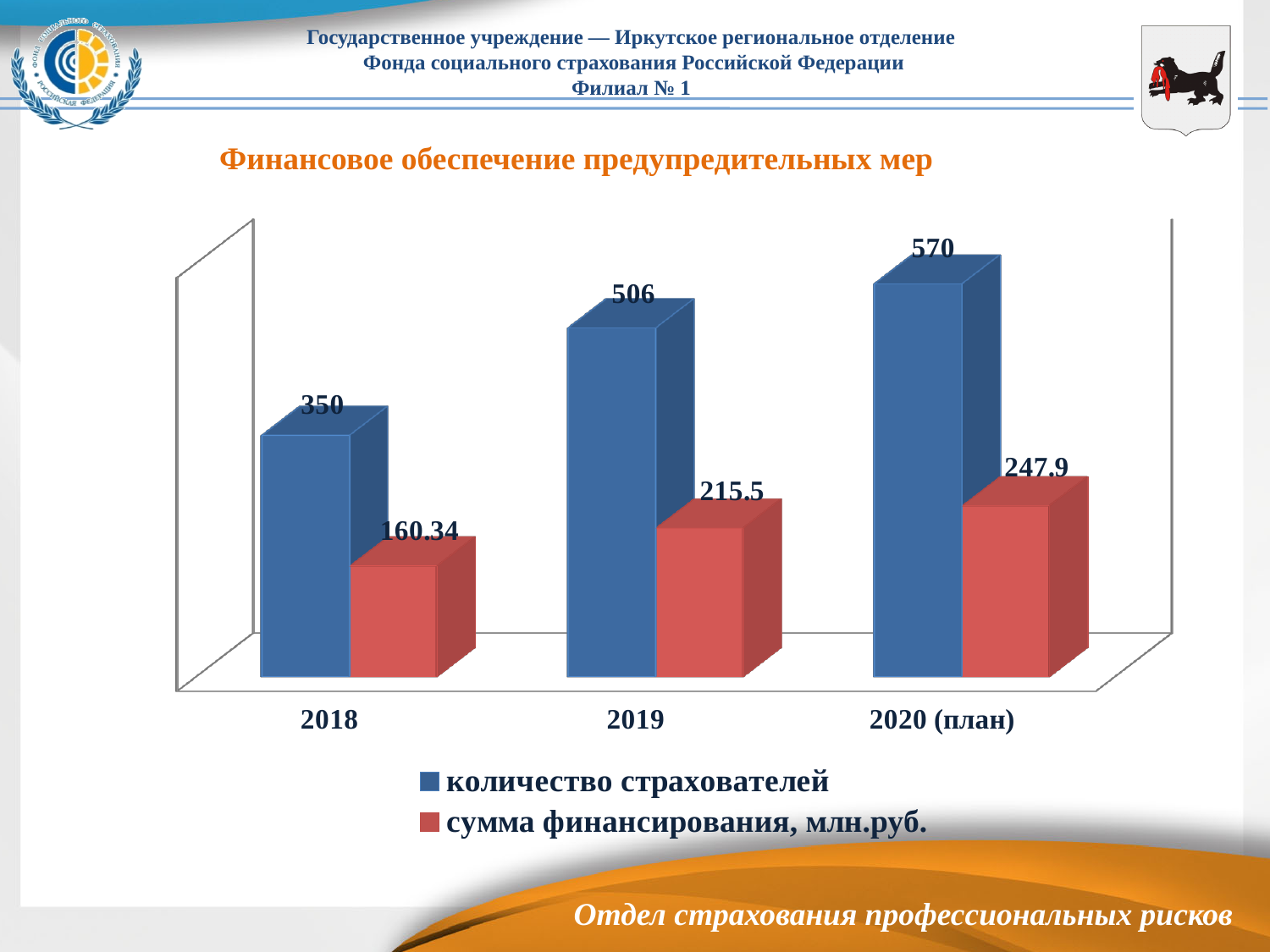
What is the difference between сумма финансирования, млн.руб. in 2019 and in 2018? 55.16 How many years are shown on the x axis? 3 Which year has the lowest value for сумма финансирования, млн.руб.? 2018 Do the values for сумма финансирования, млн.руб. rise or fall from 2018 to 2020 (план)? Rise What is the value of количество страхователей for 2019? 506 What is the difference between количество страхователей in 2020 (план) and in 2018? 220 What is the value of сумма финансирования, млн.руб. for 2020 (план)? 247.9 What kind of chart is shown on the slide? Bar chart Which is larger: количество страхователей in 2019 or in 2018? 2019 What is the value of сумма финансирования, млн.руб. for 2018? 160.34 Which year has the highest value for количество страхователей? 2020 (план) How many series does the legend list? 2